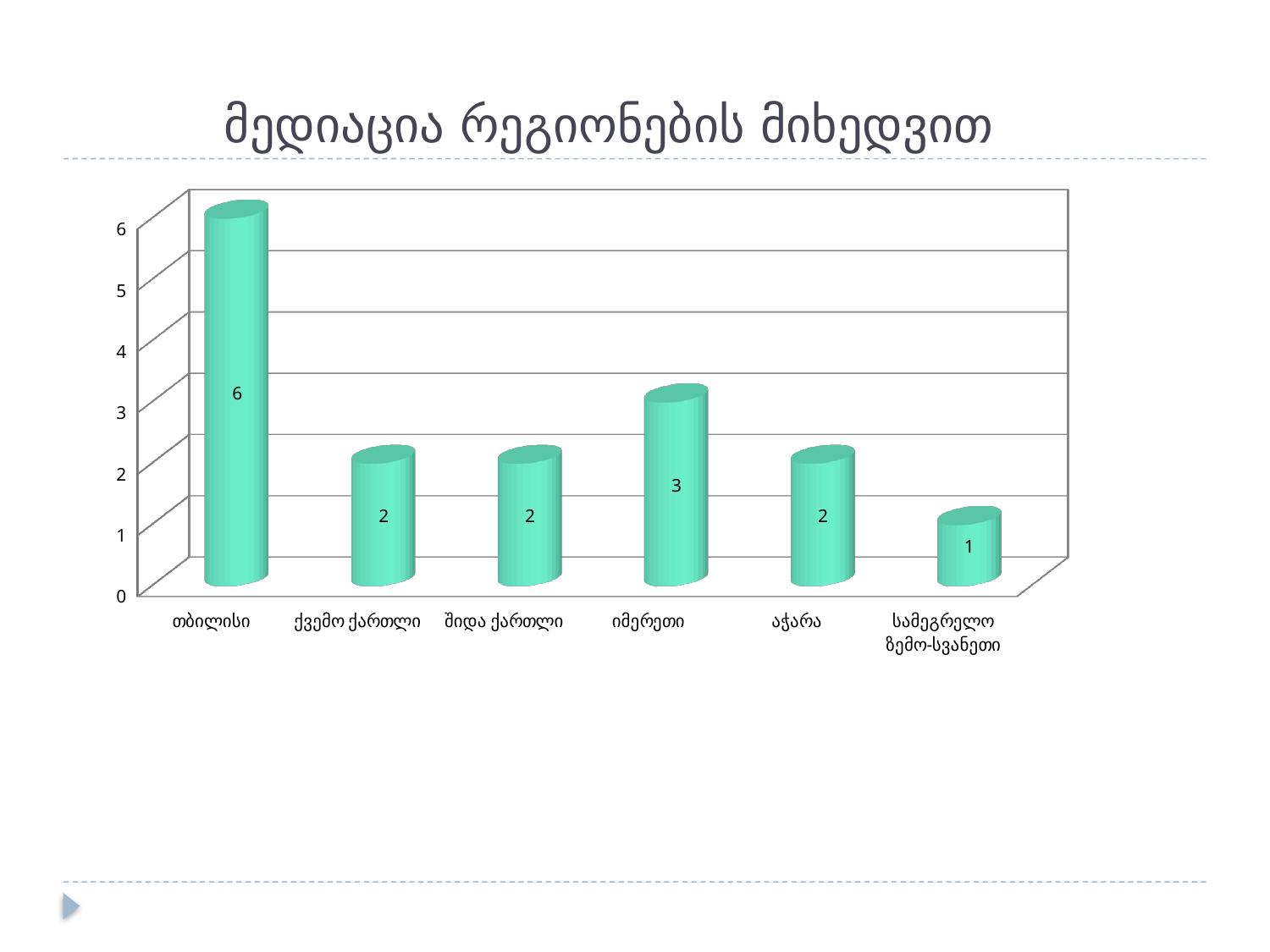
What is the value for სამეგრელო ზემო-სვანეთი? 1 Which is larger, the value for იმერეთი or the value for ქვემო ქართლი? იმერეთი What kind of chart is shown on the slide? bar chart How many regions are shown on the chart? 6 Which region has the highest value? თბილისი What is the difference between the values for თბილისი and იმერეთი? 3 What is the value for თბილისი? 6 Is the value for თბილისი greater or less than 4? greater What is the value for იმერეთი? 3 What is the value for აჭარა? 2 What is the title of the chart? მედიაცია რეგიონების მიხედვით Which region has the lowest value? სამეგრელო ზემო-სვანეთი